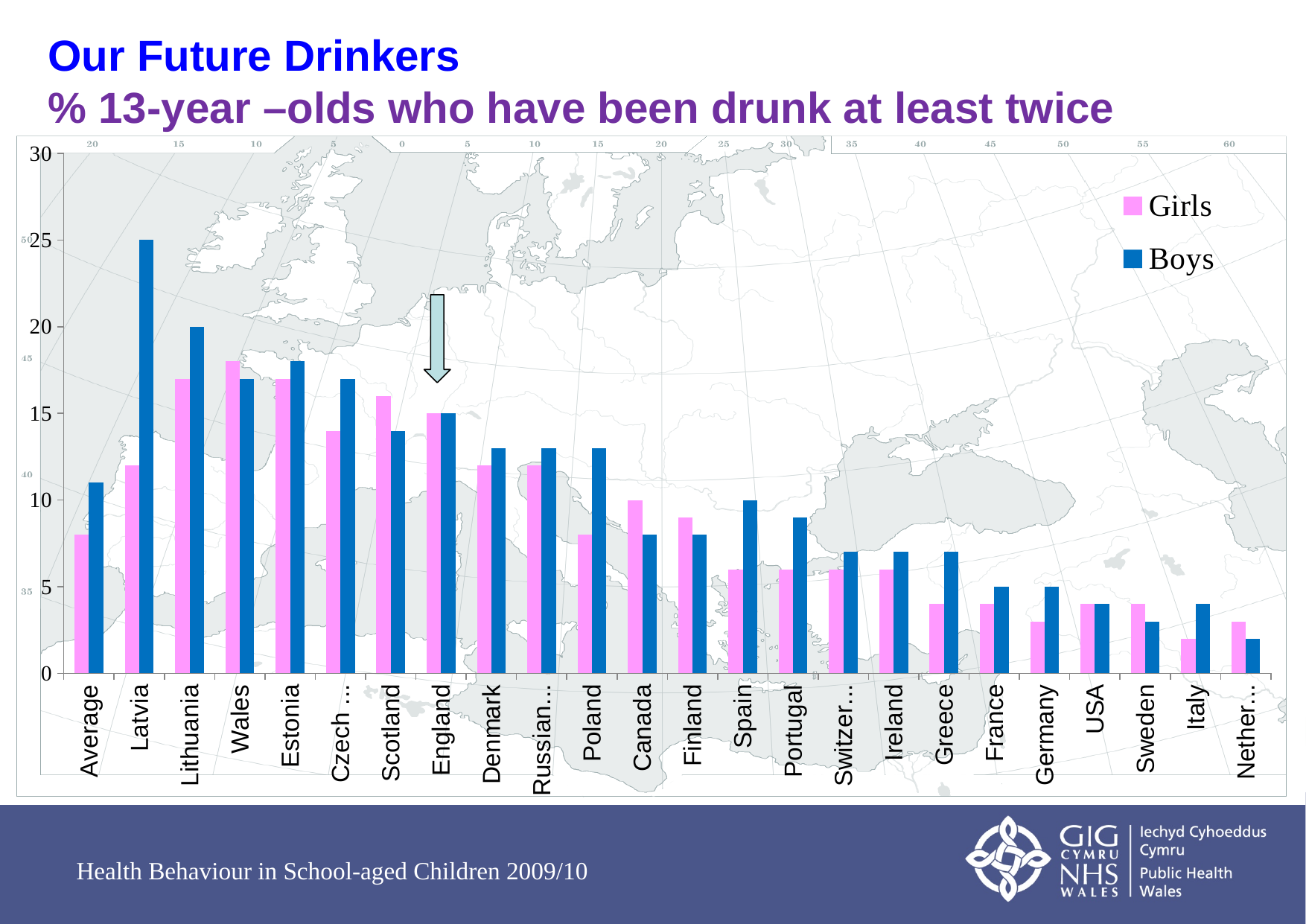
In Latvia, which is larger, the value for Girls or the value for Boys? Boys What are the two series named in the legend? Girls and Boys What is the value for Boys in Latvia? 25 What is the value for Boys in Lithuania? 20 Which category has the highest value for Boys? Latvia Which category has the lowest value for Girls? Italy How many series does the legend list? 2 Is the value for Boys in Sweden greater or less than 5? less How many categories are shown along the x axis? 24 Is the value for Girls in Wales greater or less than 15? greater Do the Boys values generally rise or fall moving from left to right along the x axis? fall What kind of chart is shown on the slide? bar chart